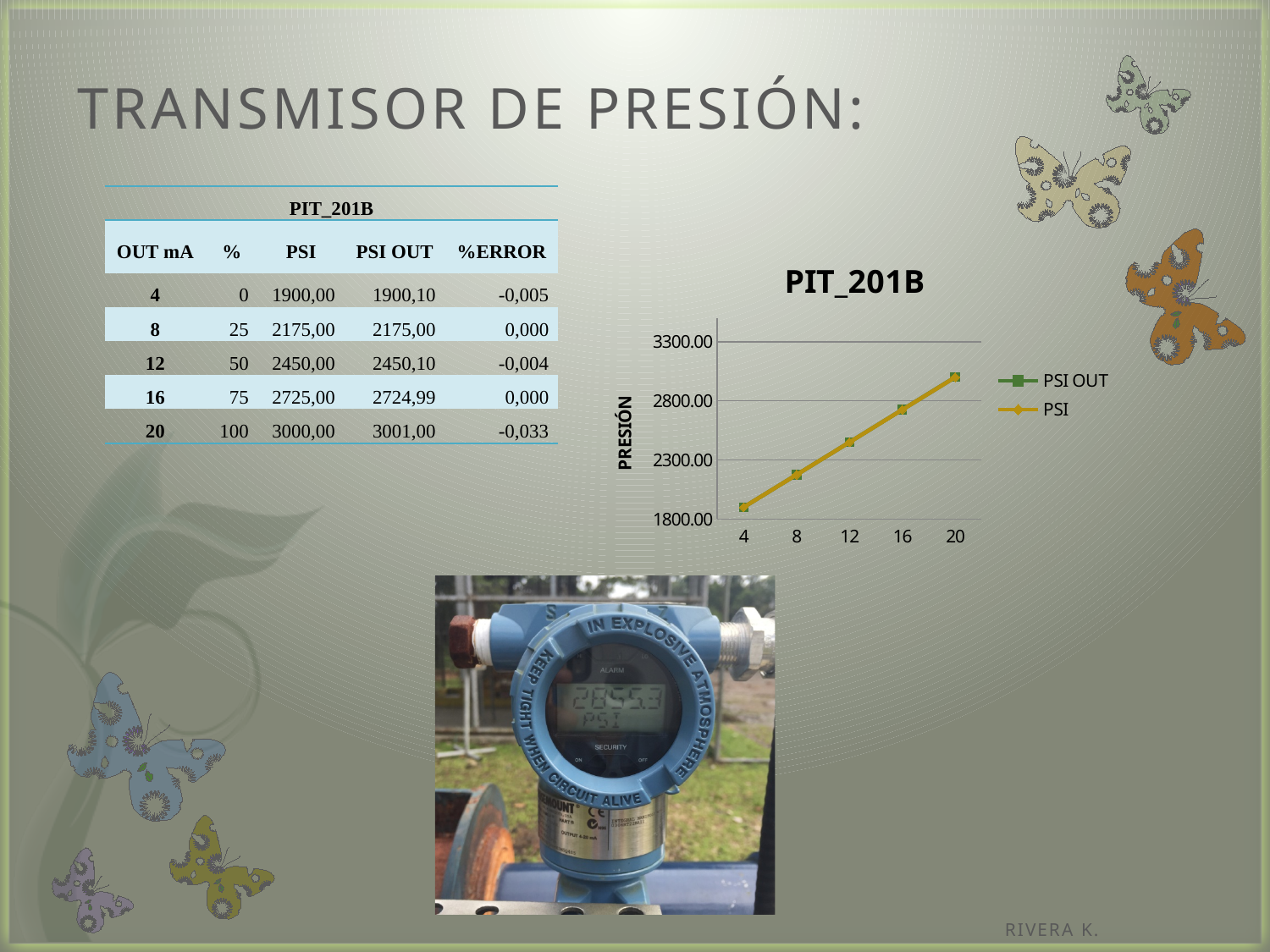
What kind of chart is shown on the slide? line chart How many points are plotted along the x axis of the chart? 5 What is the title of the chart? PIT_201B Is the PSI value at x = 20 greater or less than 2800.00? greater What are the names of the series in the chart legend? PSI OUT and PSI Is the PSI value at x = 4 greater or less than 2300.00? less At which x-axis value is the PSI series highest? 20 Do the values in the chart rise or fall as the x axis goes from 4 to 20? rise How many series does the chart legend list? 2 Is the PSI value at x = 12 greater or less than 2300.00? greater At which x-axis value is the PSI series lowest? 4